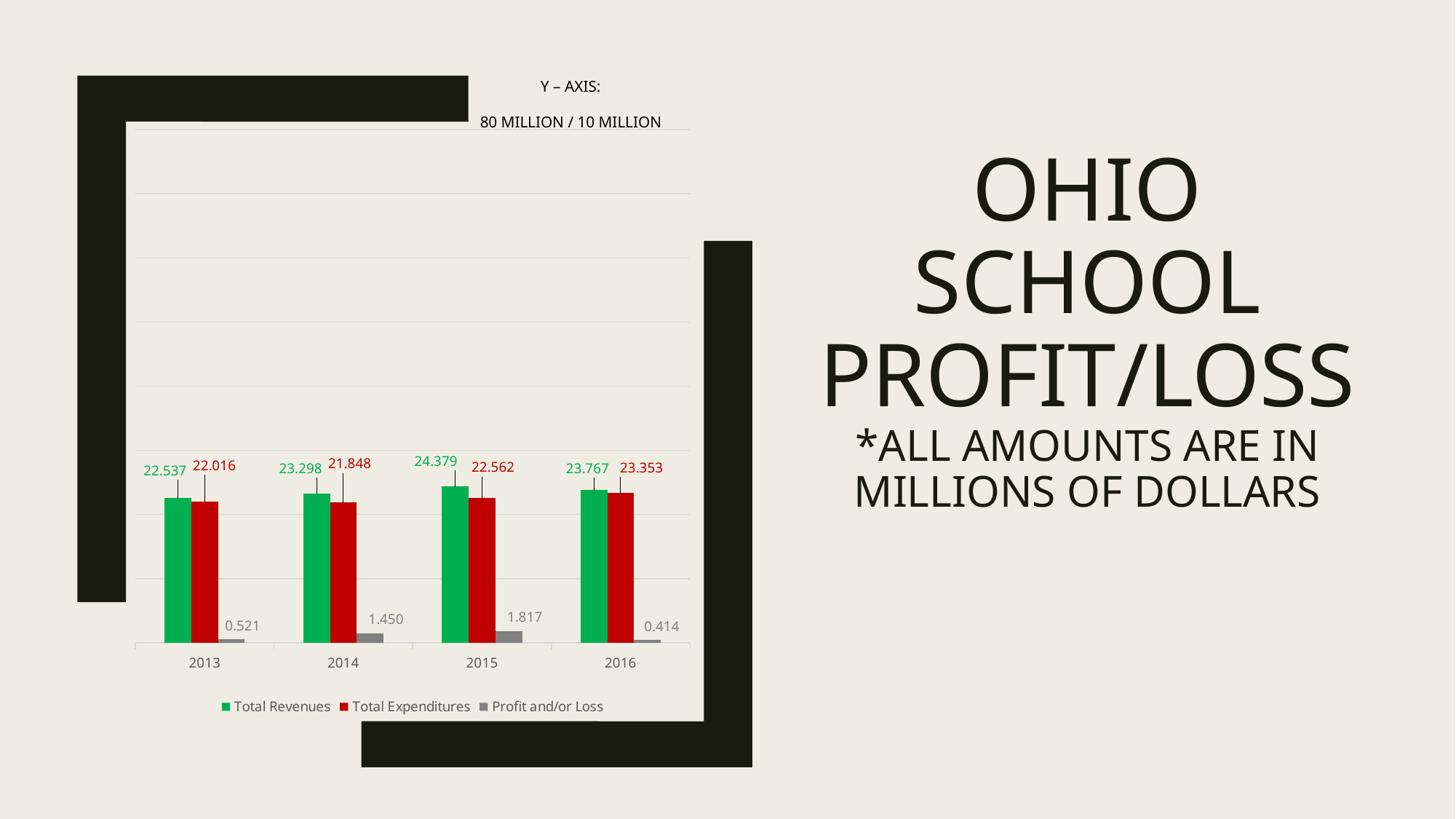
Which year has the lowest Profit and/or Loss? 2016 Which is larger in 2013, Total Revenues or Total Expenditures? Total Revenues What is the Total Revenues value for 2015? 24.379 What is the difference between Total Revenues and Total Expenditures in 2015? 1.817 How many years are shown on the x axis? 4 What is the Profit and/or Loss value for 2016? 0.414 Which year has the highest Profit and/or Loss? 2015 What kind of chart is shown on the slide? Bar chart How many series does the legend list? 3 Do Total Revenues rise or fall from 2013 to 2015? Rise Which year has the highest Total Revenues? 2015 What is the Total Expenditures value for 2014? 21.848